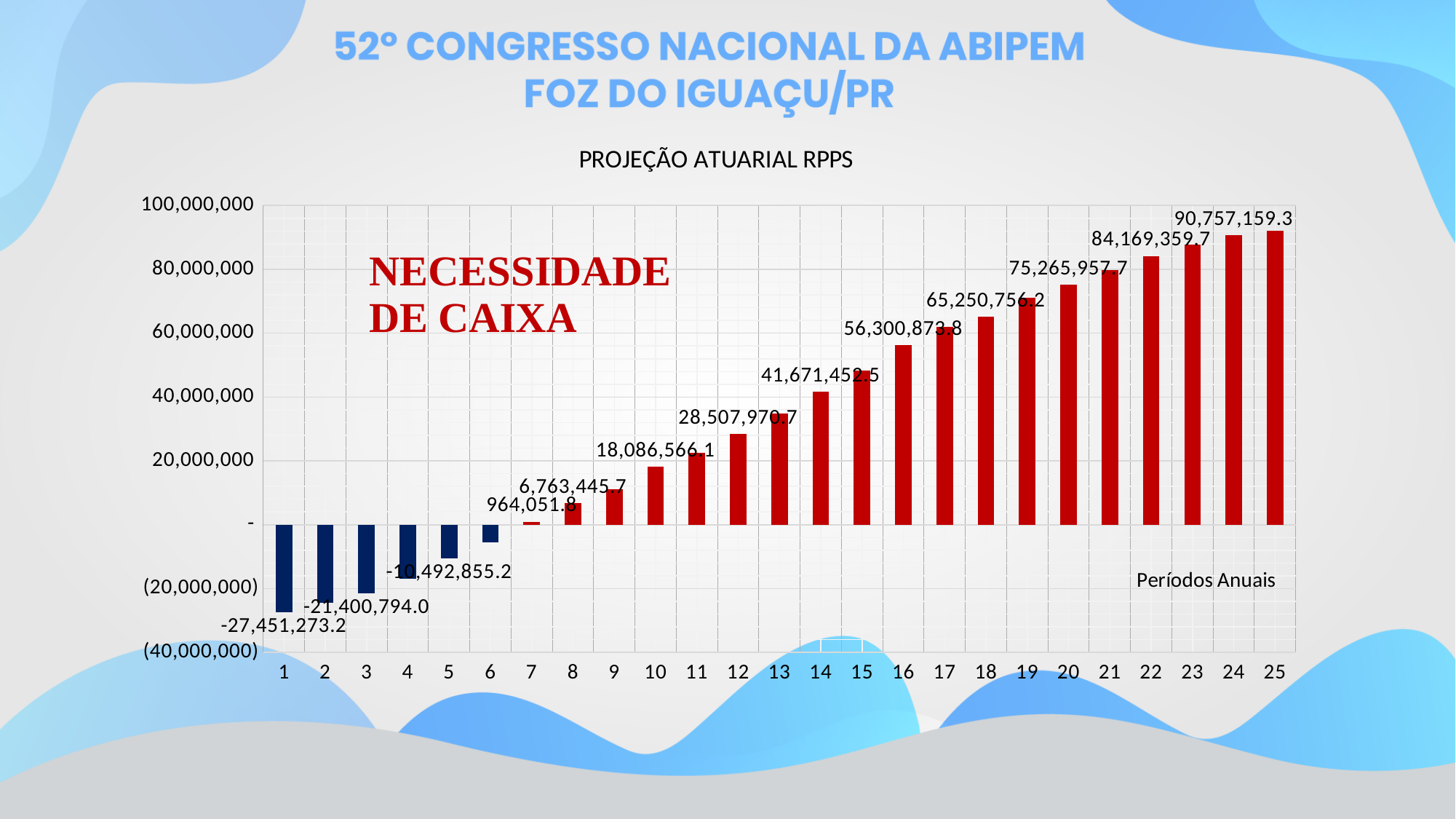
What is the value for period 24? 90,757,159.3 Is the value for period 25 greater or less than 80,000,000? greater What kind of chart is shown on the slide? bar chart How many periods are plotted along the x axis? 25 What is the title of the chart? PROJEÇÃO ATUARIAL RPPS Do the values rise or fall as the periods increase from 1 to 25? rise What is the value for period 7? 964,051.8 Which is larger, the value for period 20 or the value for period 10? period 20 Which period has the lowest value? 1 What is the value for period 1? -27,451,273.2 Which period has the highest value? 25 What label is shown for the x axis? Períodos Anuais